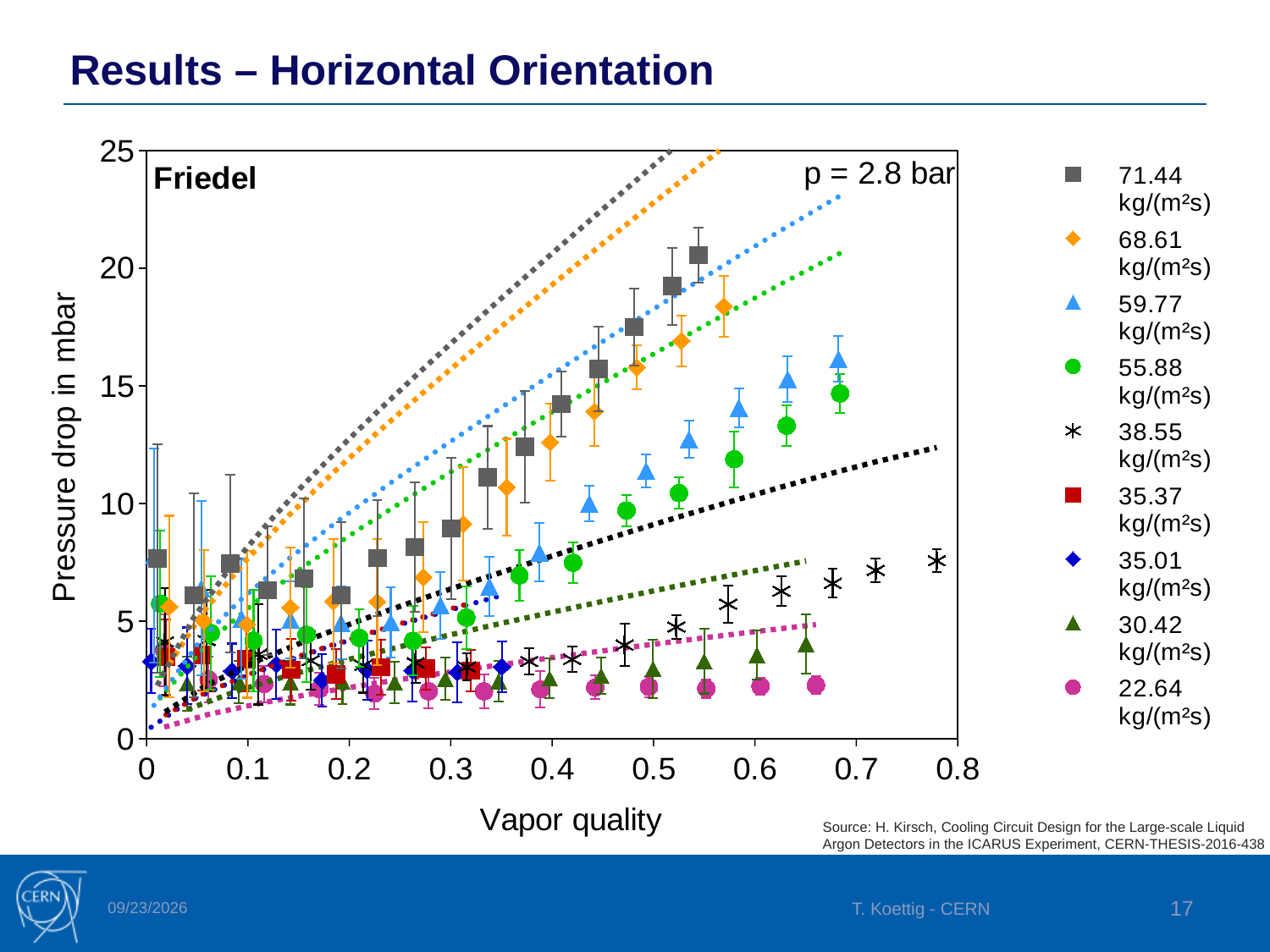
How many series does the legend list? 9 Which series reaches the highest pressure drop in the chart? 71.44 kg/(m²s) Is the pressure drop for the 38.55 kg/(m²s) series at a vapor quality of about 0.78 greater or less than 10? less Does the pressure drop for the 71.44 kg/(m²s) series rise or fall as vapor quality increases? rise Is the pressure drop for the 71.44 kg/(m²s) series at a vapor quality of about 0.5 greater or less than 15? greater What is the label of the y axis? Pressure drop in mbar What kind of chart is shown on the slide? scatter chart Is the pressure drop for the 22.64 kg/(m²s) series at a vapor quality of about 0.6 greater or less than 5? less At a vapor quality of about 0.5, which series has the larger pressure drop: 59.77 kg/(m²s) or 30.42 kg/(m²s)? 59.77 kg/(m²s) What pressure is stated in the top right corner of the plot area? p = 2.8 bar What is the label of the x axis? Vapor quality Which series has the lowest pressure drop values in the chart? 22.64 kg/(m²s)